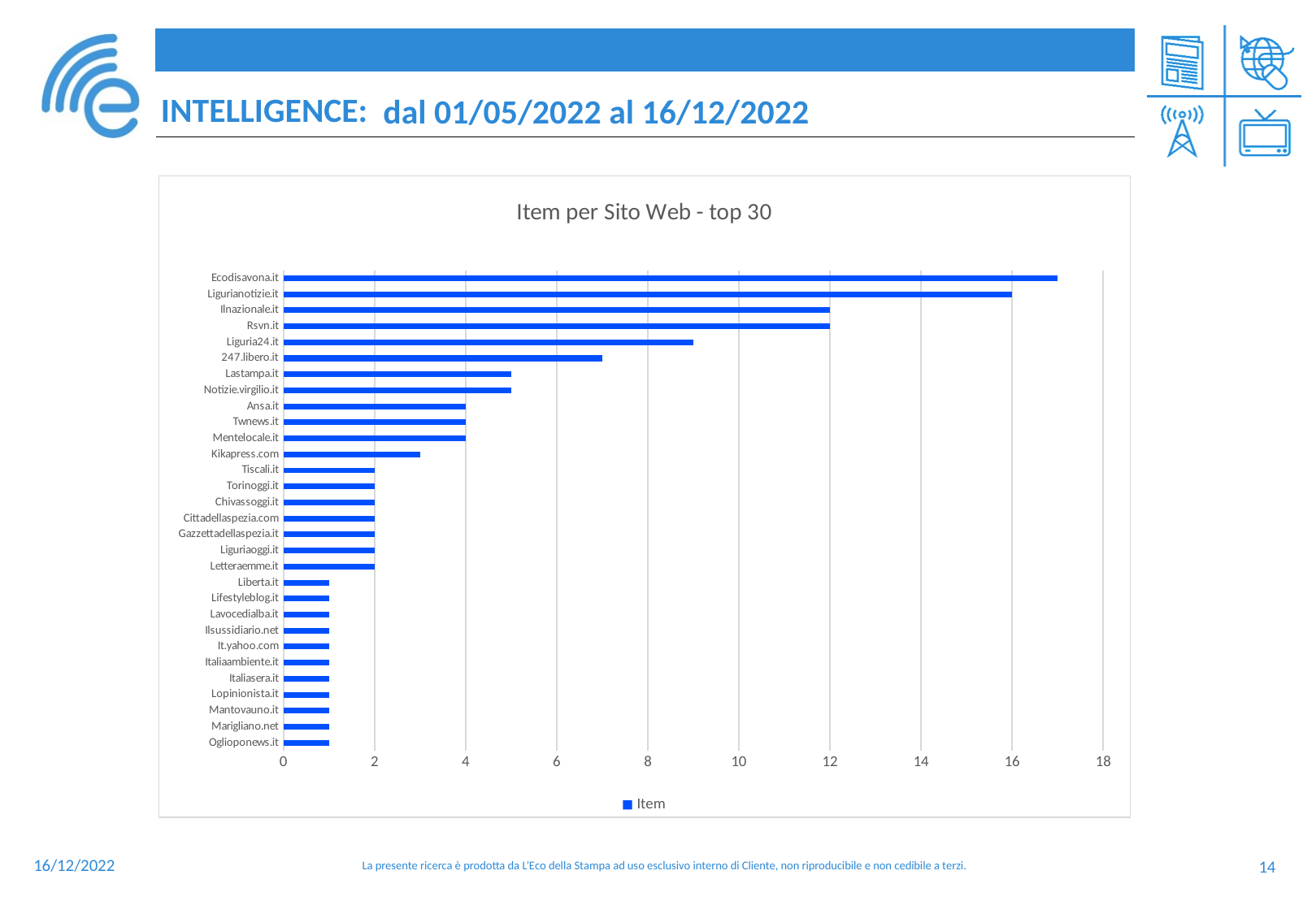
What is the difference between the values for Ligurianotizie.it and Ilnazionale.it? 4 Is the value for Liguria24.it greater or less than 8? greater Is the value for Ecodisavona.it greater or less than 16? greater How many websites are shown in the chart? 30 What is the value for Ligurianotizie.it? 16 What is the title of the chart? Item per Sito Web - top 30 Which website has the highest number of items? Ecodisavona.it Which has a larger value, Liguria24.it or 247.libero.it? Liguria24.it What is the value for Ansa.it? 4 What kind of chart is shown on the slide? bar chart How many series does the legend list? 1 What is the value for Ilnazionale.it? 12